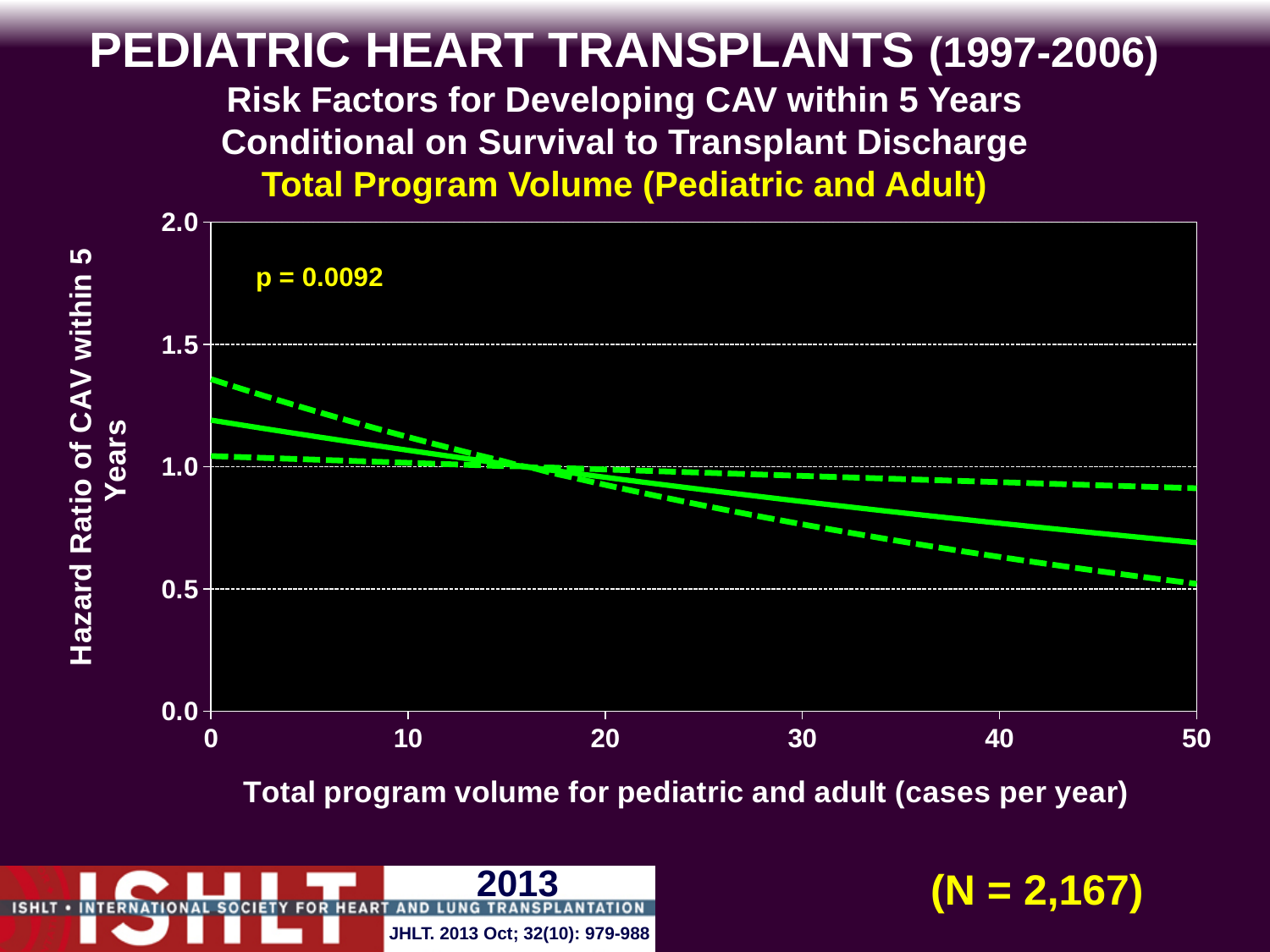
What sample size (N) is shown on the slide? N = 2,167 What p-value is printed on the chart? p = 0.0092 What kind of chart is shown on the slide? line chart Does the solid hazard ratio line rise or fall as total program volume increases from 0 to 50 cases per year? fall What is the highest value shown on the y axis of the chart? 2.0 Is the solid hazard ratio line higher at a program volume of 0 or at a program volume of 50? 0 Is the value of the solid hazard ratio line at a program volume of 0 greater or less than 1.0? greater Is the value of the solid hazard ratio line at a program volume of 50 greater or less than 1.0? less Is the value of the upper dashed line at a program volume of 50 greater or less than 1.0? less How many lines are plotted on the chart? 3